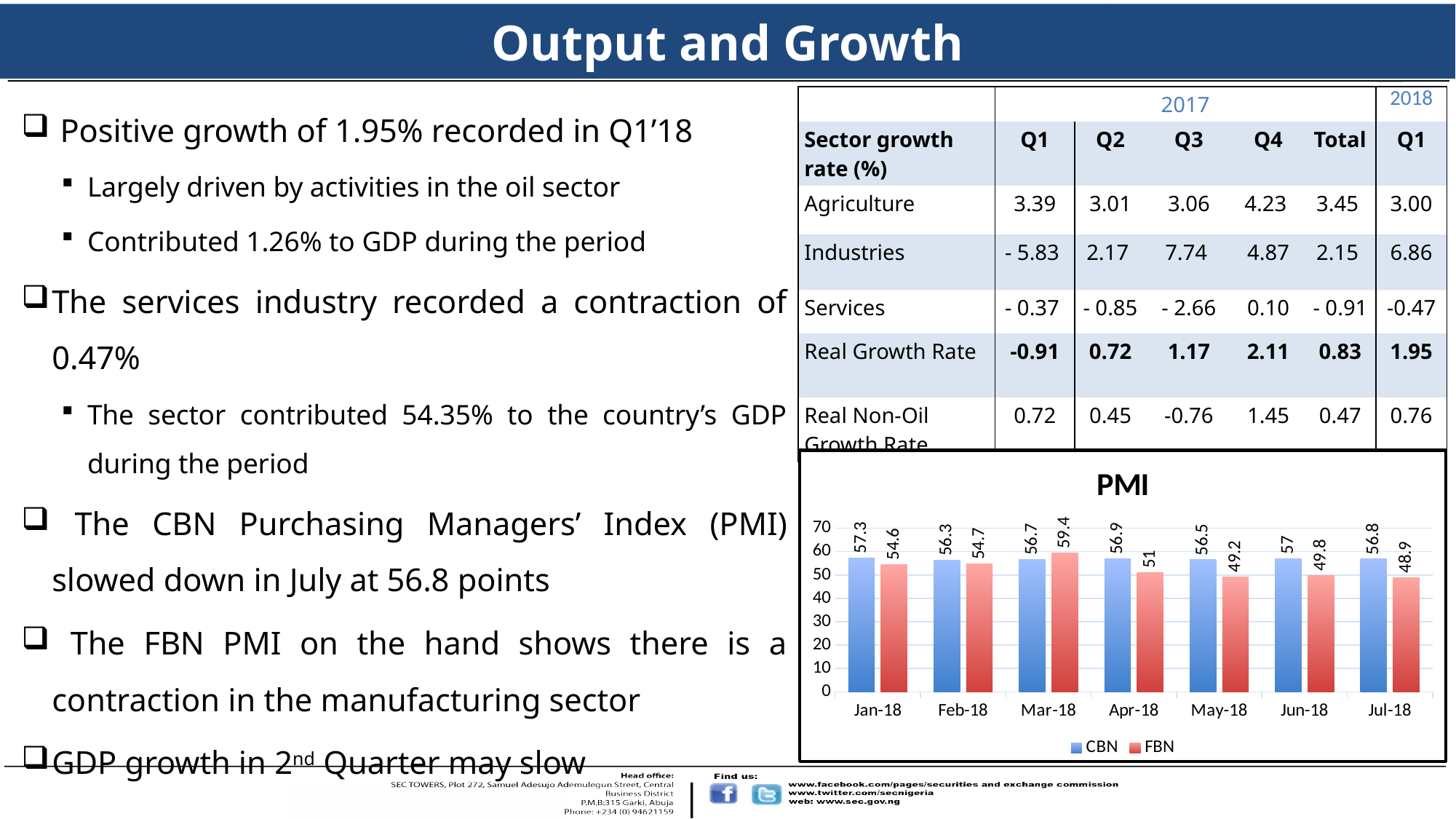
Does the FBN PMI rise or fall from Mar-18 to Jul-18? fall Which is larger in Mar-18, the CBN PMI or the FBN PMI? FBN In which month is the FBN PMI lowest? Jul-18 How many series does the legend of the PMI chart list? 2 In which month is the FBN PMI highest? Mar-18 What is the FBN PMI value for Mar-18? 59.4 How many months are shown on the x axis of the PMI chart? 7 What kind of chart is the PMI chart? bar chart What is the CBN PMI value for Jan-18? 57.3 What is the difference between the CBN and FBN PMI values in May-18? 7.3 Is the FBN PMI value for Apr-18 greater or less than 60? less What is the FBN PMI value for Jul-18? 48.9